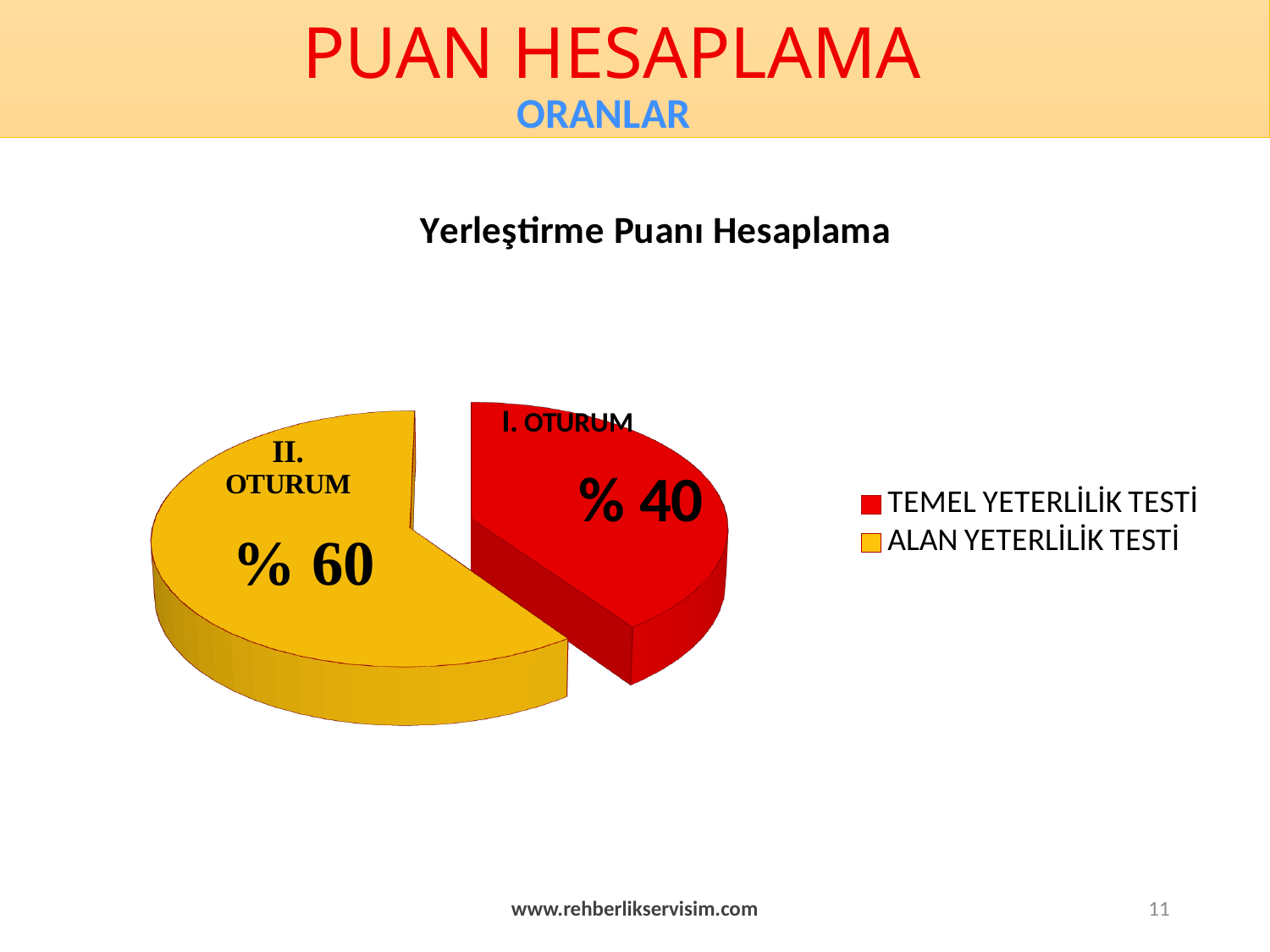
Which is larger, the I. OTURUM slice or the II. OTURUM slice? II. OTURUM Which slice is the largest? ALAN YETERLİLİK TESTİ What share of the pie does TEMEL YETERLİLİK TESTİ (I. OTURUM) take? % 40 What kind of chart is shown on the slide? pie chart Which slice is the smallest? TEMEL YETERLİLİK TESTİ What is the value printed on the red slice? % 40 How many slices does the pie chart have? 2 Which colour represents TEMEL YETERLİLİK TESTİ in the legend? red How many entries does the legend list? 2 What is the chart's title? Yerleştirme Puanı Hesaplama What is the difference in percentage points between the II. OTURUM slice and the I. OTURUM slice? 20 What share of the pie does ALAN YETERLİLİK TESTİ (II. OTURUM) take? % 60